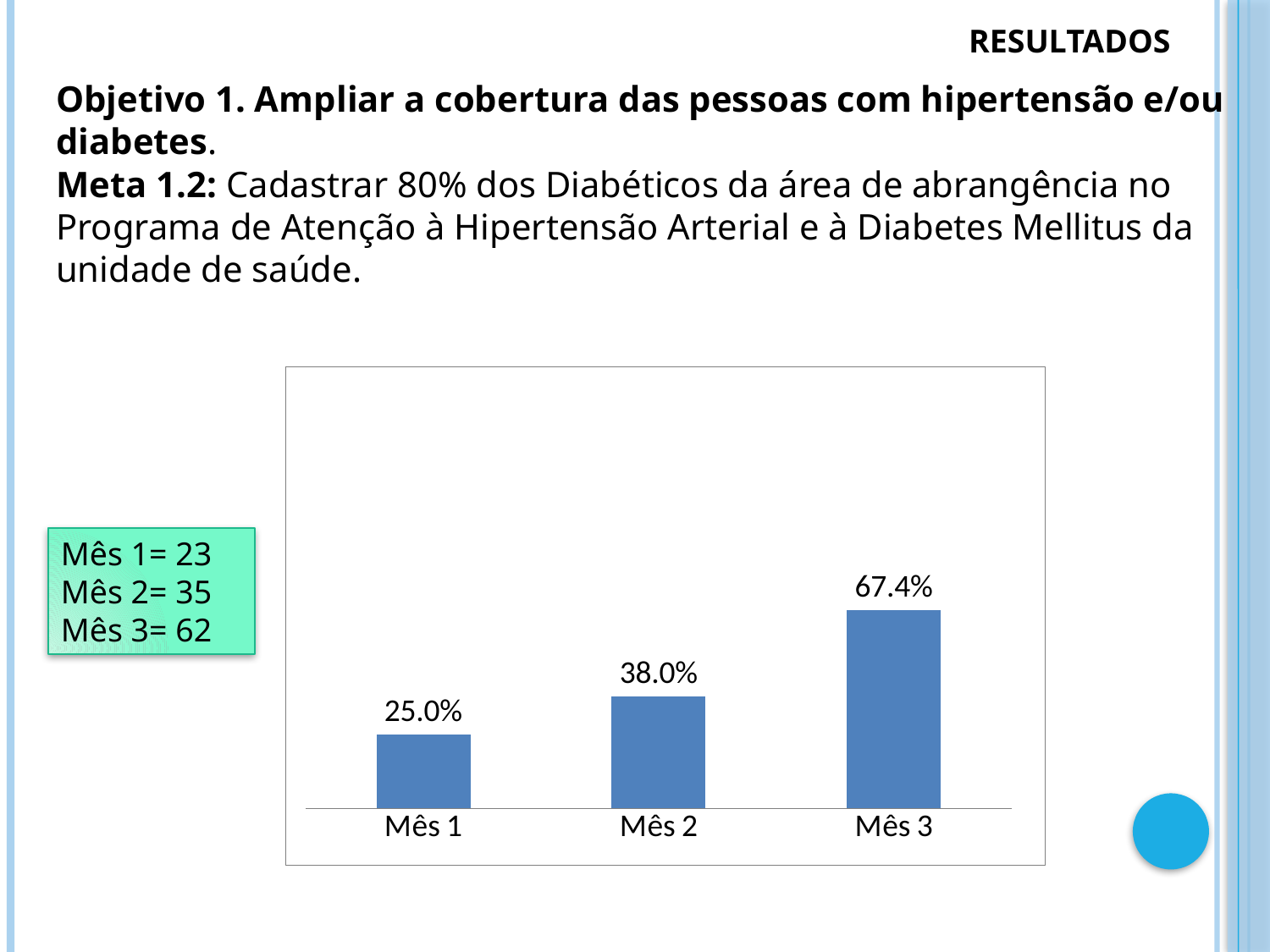
Which month has the lowest value? Mês 1 How many categories are shown on the x axis? 3 What is the difference between the values for Mês 3 and Mês 2? 29.4% What is the value for Mês 3? 67.4% Which month has the highest value? Mês 3 Do the values rise or fall from Mês 1 to Mês 3? Rise What is the value for Mês 1? 25.0% What colour are the bars in the chart? Blue What is the difference between the values for Mês 2 and Mês 1? 13.0% What is the value for Mês 2? 38.0% Which is larger, the value for Mês 1 or the value for Mês 2? Mês 2 What kind of chart is shown on the slide? Bar chart